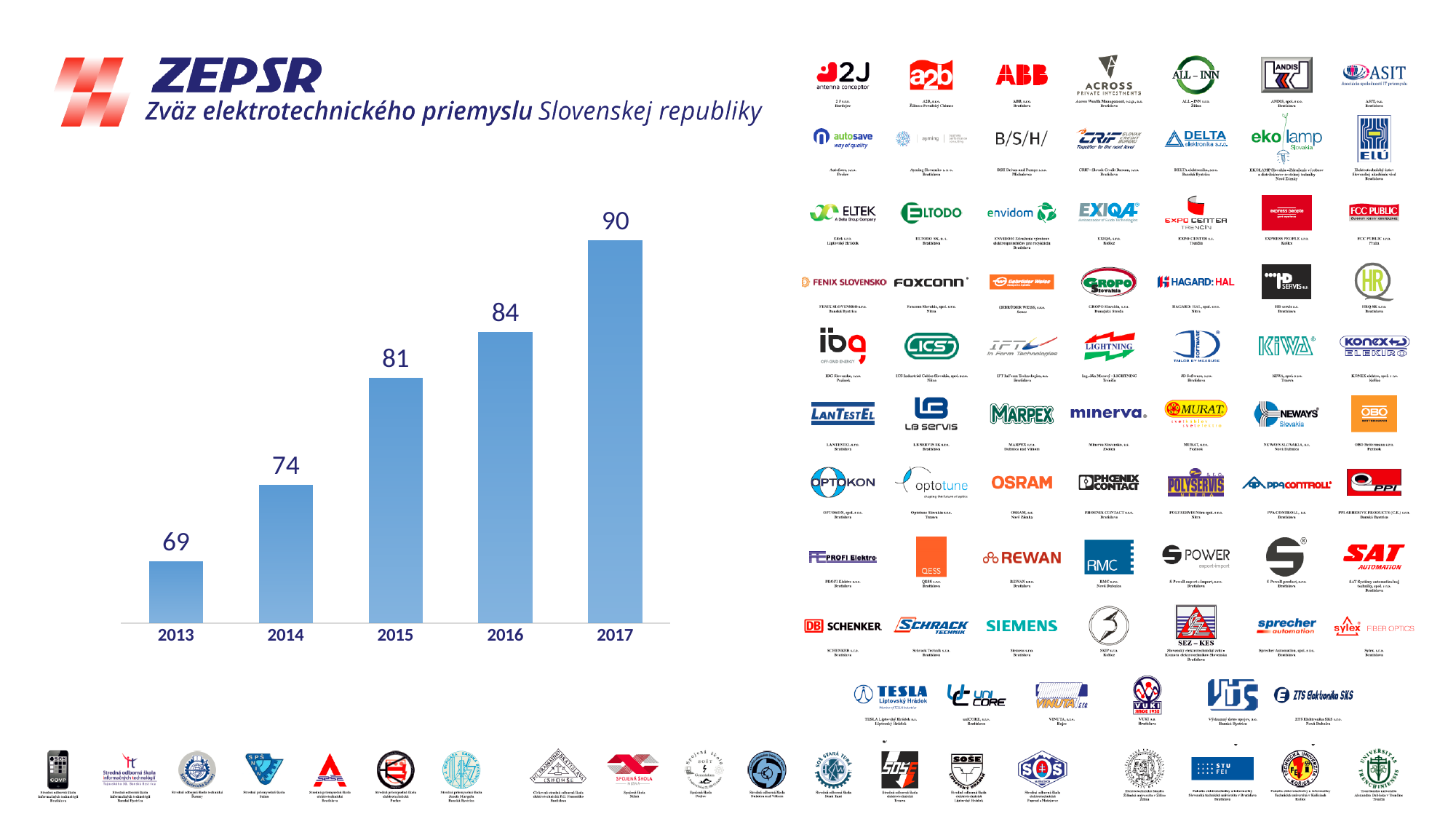
Which year has the lowest value in the bar chart? 2013 What kind of chart is shown on the slide? bar chart What colour are the bars in the chart? blue What is the difference between the values for 2017 and 2013? 21 How many years are shown on the x axis of the bar chart? 5 What is the value shown for 2017? 90 What is the difference between the values for 2016 and 2015? 3 What is the value shown for 2015? 81 Which is larger, the value for 2014 or the value for 2016? 2016 Which year has the highest value in the bar chart? 2017 Do the values rise or fall from 2013 to 2017? rise What is the value shown for 2013? 69